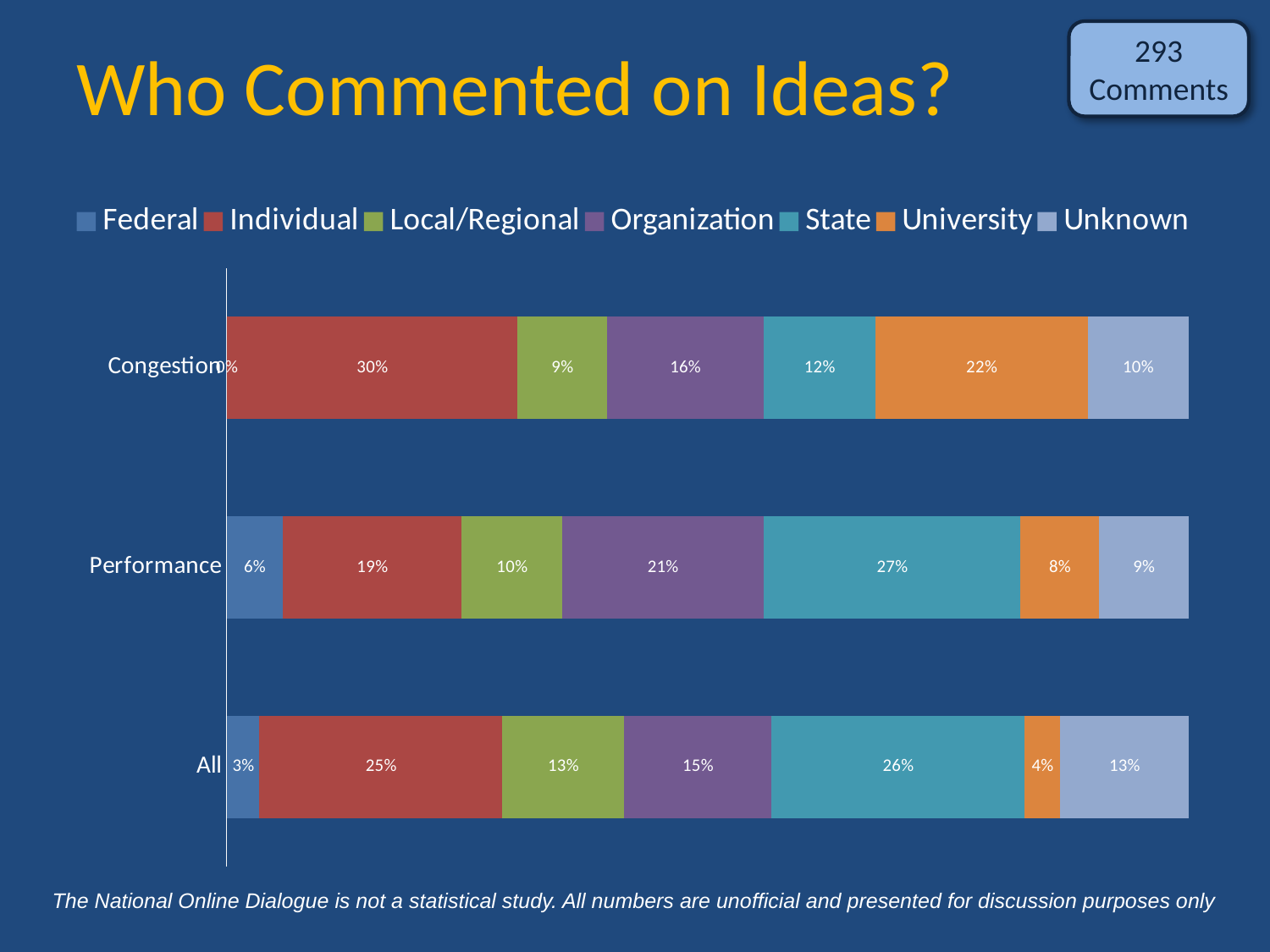
How many categories (bars) are shown on the chart? 3 What is the Organization share for Performance? 21% What is the State share for Performance? 27% How many series does the legend list? 7 What is the title of the slide containing the chart? Who Commented on Ideas? Which series has the largest share in the Congestion bar? Individual What is the Individual share for Congestion? 30% What kind of chart is shown on the slide? Stacked bar chart Which is larger: the State share for All or the Individual share for All? State What is the University share for All? 4% Which series has the smallest share in the All bar? Federal What is the difference between the University share for Congestion and the University share for Performance? 14%